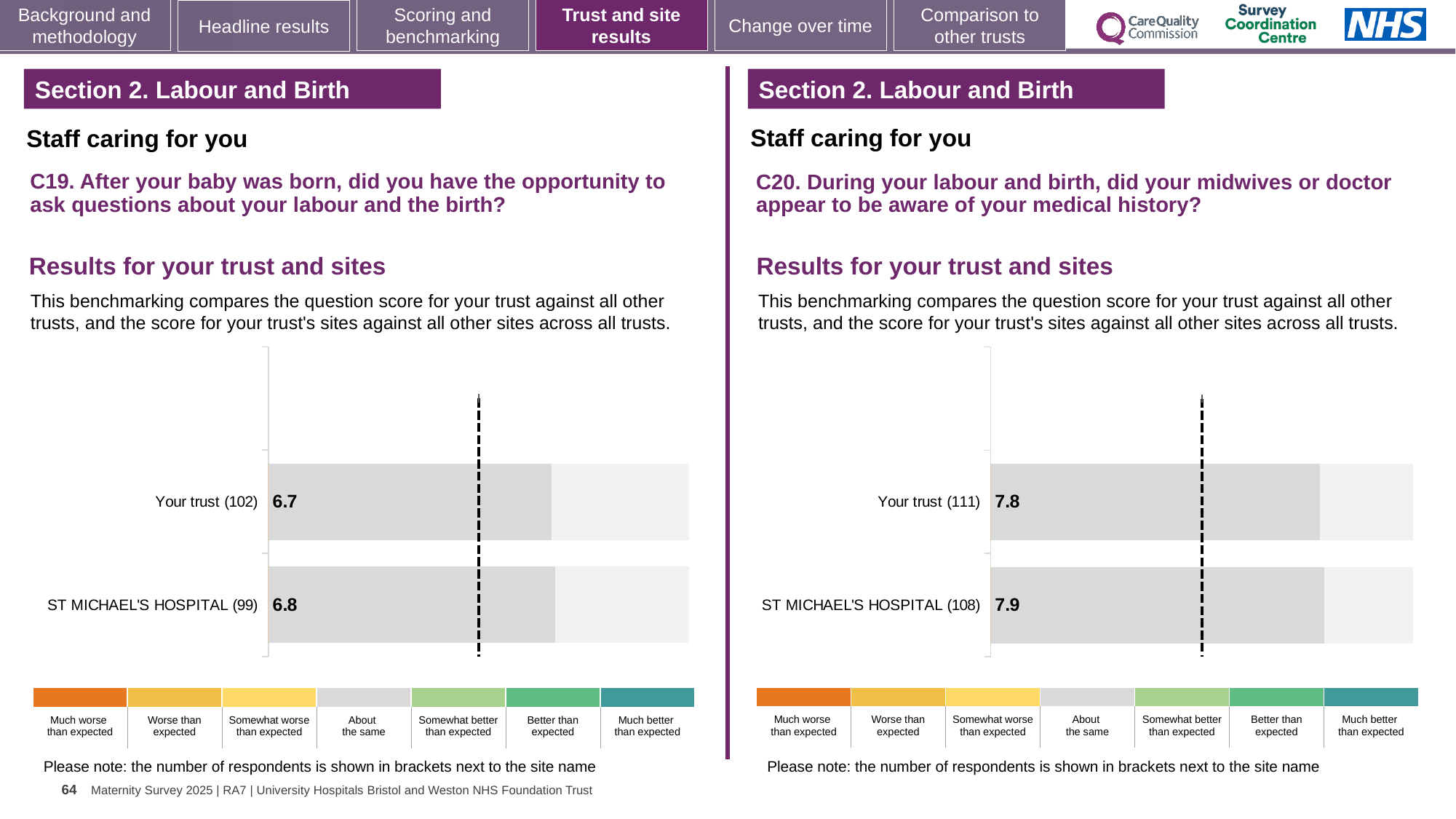
In the C20 chart on the right, what is the score for Your trust? 7.8 In the C19 chart on the left, what is the score for ST MICHAEL'S HOSPITAL? 6.8 What type of chart is used in the C19 chart on the left? Bar chart How many bars are plotted in the C20 chart on the right? 2 In the C19 chart on the left, what is the score for Your trust? 6.7 In the C19 chart on the left, how many respondents are shown in brackets for Your trust? 102 In the C19 chart on the left, which has the higher score, Your trust or ST MICHAEL'S HOSPITAL? ST MICHAEL'S HOSPITAL In the C20 chart on the right, which category has the lowest score? Your trust In the C20 chart on the right, what is the score for ST MICHAEL'S HOSPITAL? 7.9 In the C19 chart on the left, what is the difference between the ST MICHAEL'S HOSPITAL score and the Your trust score? 0.1 In the C20 chart on the right, how many respondents are shown in brackets for ST MICHAEL'S HOSPITAL? 108 In the C20 chart on the right, what is the difference between the ST MICHAEL'S HOSPITAL score and the Your trust score? 0.1